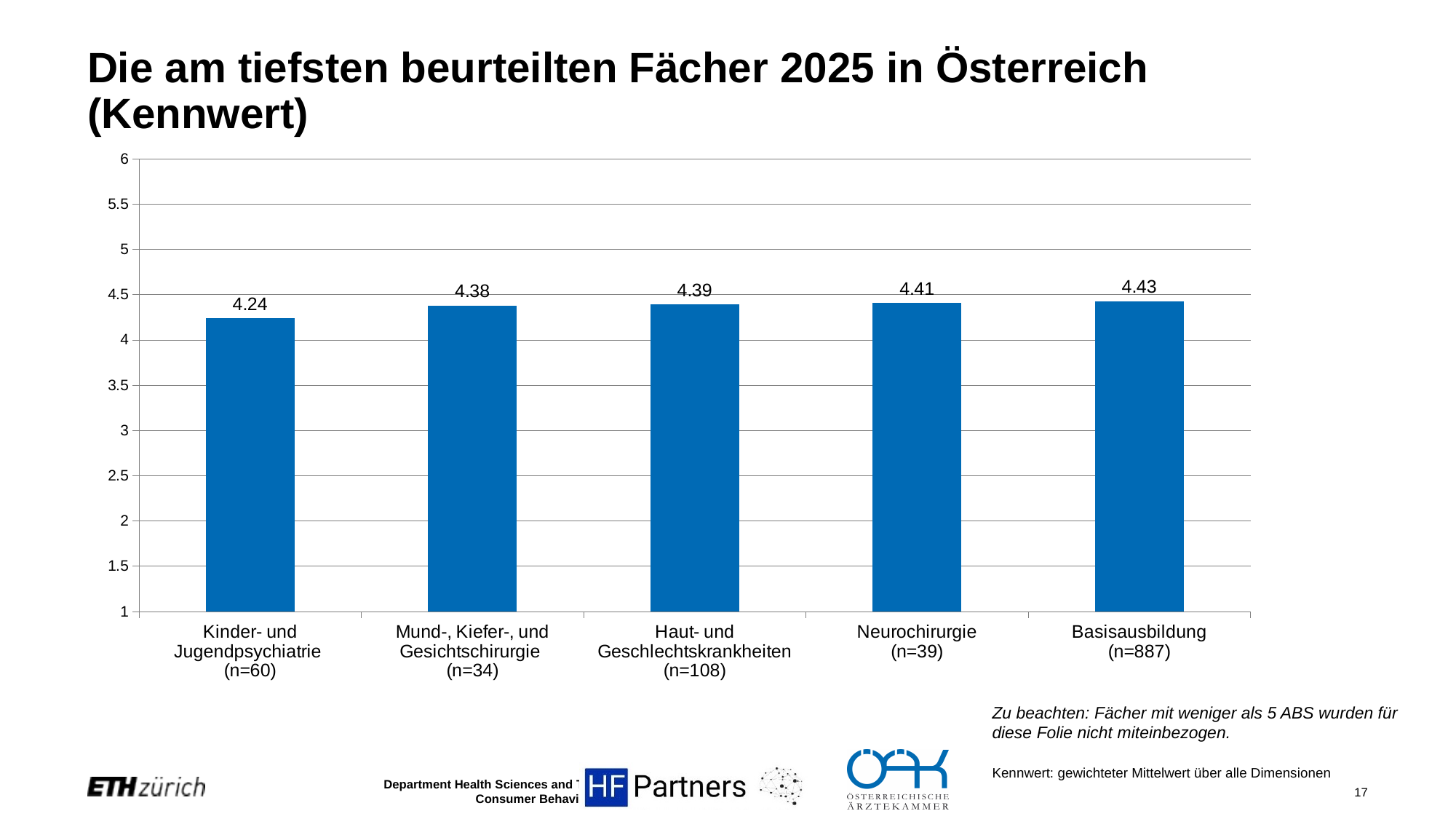
What is the Kennwert value for Haut- und Geschlechtskrankheiten (n=108)? 4.39 What is the Kennwert value for Kinder- und Jugendpsychiatrie (n=60)? 4.24 Which category has the lowest value in the chart? Kinder- und Jugendpsychiatrie (n=60) How many categories are shown in the chart? 5 What is the difference between the values for Basisausbildung and Kinder- und Jugendpsychiatrie? 0.19 What is the Kennwert value for Neurochirurgie (n=39)? 4.41 Do the values rise or fall from left to right along the x axis? Rise Which has a larger value: Neurochirurgie or Kinder- und Jugendpsychiatrie? Neurochirurgie What is the Kennwert value for Basisausbildung (n=887)? 4.43 What kind of chart is shown on the slide? Bar chart Which category has the highest value in the chart? Basisausbildung (n=887) What is the difference between the values for Mund-, Kiefer-, und Gesichtschirurgie and Kinder- und Jugendpsychiatrie? 0.14